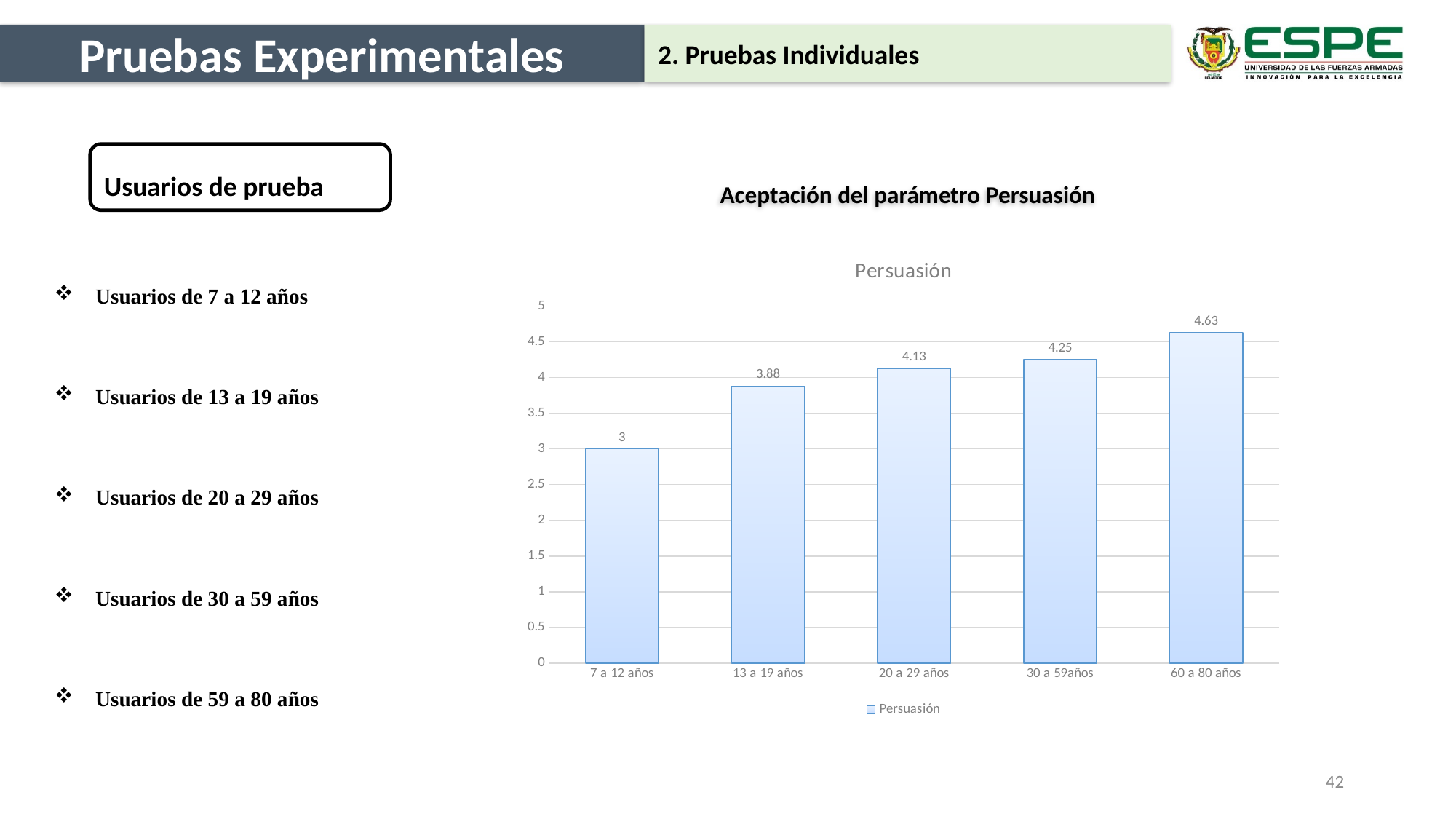
Which age group has the highest Persuasión value? 60 a 80 años What is the Persuasión value for the 7 a 12 años group? 3 Which age group has the lowest Persuasión value? 7 a 12 años What is the Persuasión value for the 60 a 80 años group? 4.63 Is the Persuasión value for 30 a 59años greater or less than 4? greater Do the Persuasión values rise or fall from the youngest to the oldest age group? rise What kind of chart is shown on the slide? bar chart What is the Persuasión value for the 13 a 19 años group? 3.88 How many age groups are shown in the chart? 5 Which has a larger Persuasión value, 13 a 19 años or 30 a 59años? 30 a 59años What is the difference between the Persuasión values for 60 a 80 años and 7 a 12 años? 1.63 What is the Persuasión value for the 20 a 29 años group? 4.13